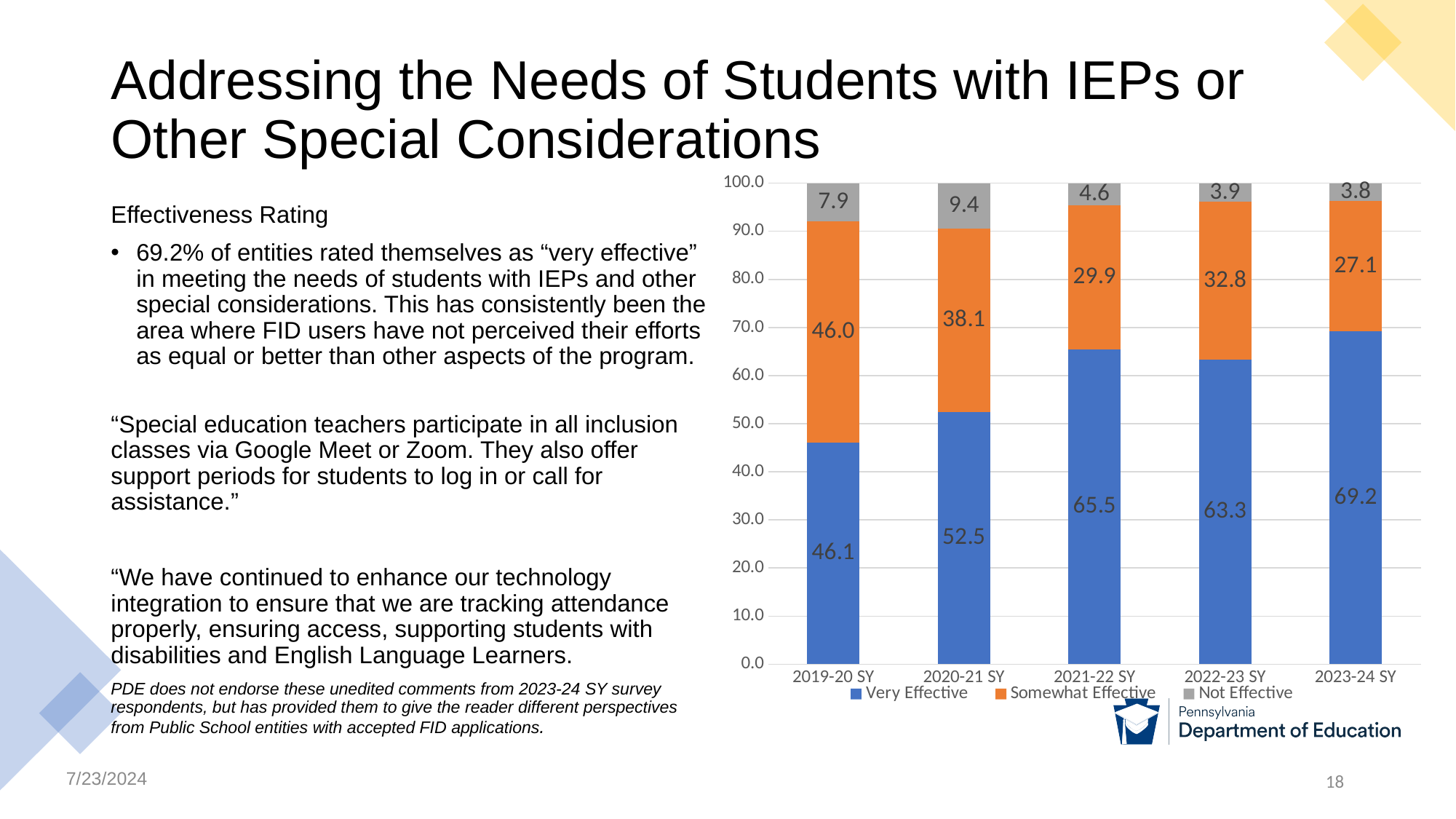
How many series does the chart legend list? 3 What is the Somewhat Effective value for 2020-21 SY? 38.1 How many school years are shown on the x axis of the chart? 5 Which school year has the highest Not Effective value? 2020-21 SY What is the difference between the Very Effective values for 2023-24 SY and 2019-20 SY? 23.1 What is the Not Effective value for 2019-20 SY? 7.9 Is the Very Effective value for 2021-22 SY or 2022-23 SY larger? 2021-22 SY What is the Very Effective value for 2023-24 SY? 69.2 Which school year has the highest Very Effective value? 2023-24 SY Which school year has the lowest Somewhat Effective value? 2023-24 SY What is the total of the stacked bar for 2021-22 SY? 100.0 What type of chart is shown on the slide? Stacked bar chart